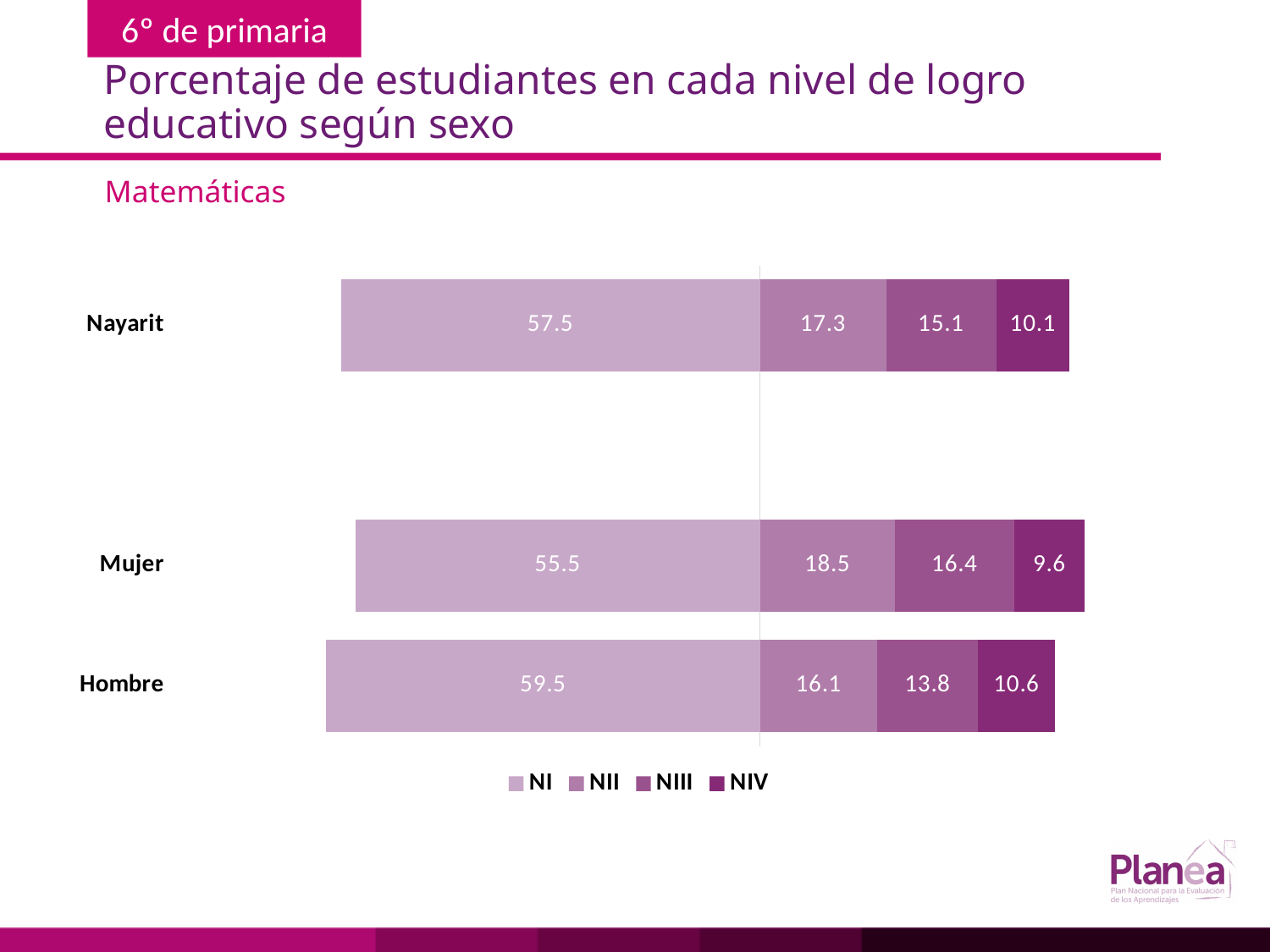
What is the NI value for Nayarit? 57.5 What is the difference between the NI values for Hombre and Mujer? 4.0 What kind of chart is shown on the slide? Stacked bar chart What is the NIII value for Hombre? 13.8 What is the NIV value for Mujer? 9.6 Which is larger, the NII value for Nayarit or the NII value for Hombre? Nayarit What is the total of the stacked bar for Nayarit? 100.0 How many series does the legend list? 4 Which category has the highest NI value? Hombre What is the NII value for Mujer? 18.5 How many categories are shown on the chart? 3 Which category has the lowest NIII value? Hombre